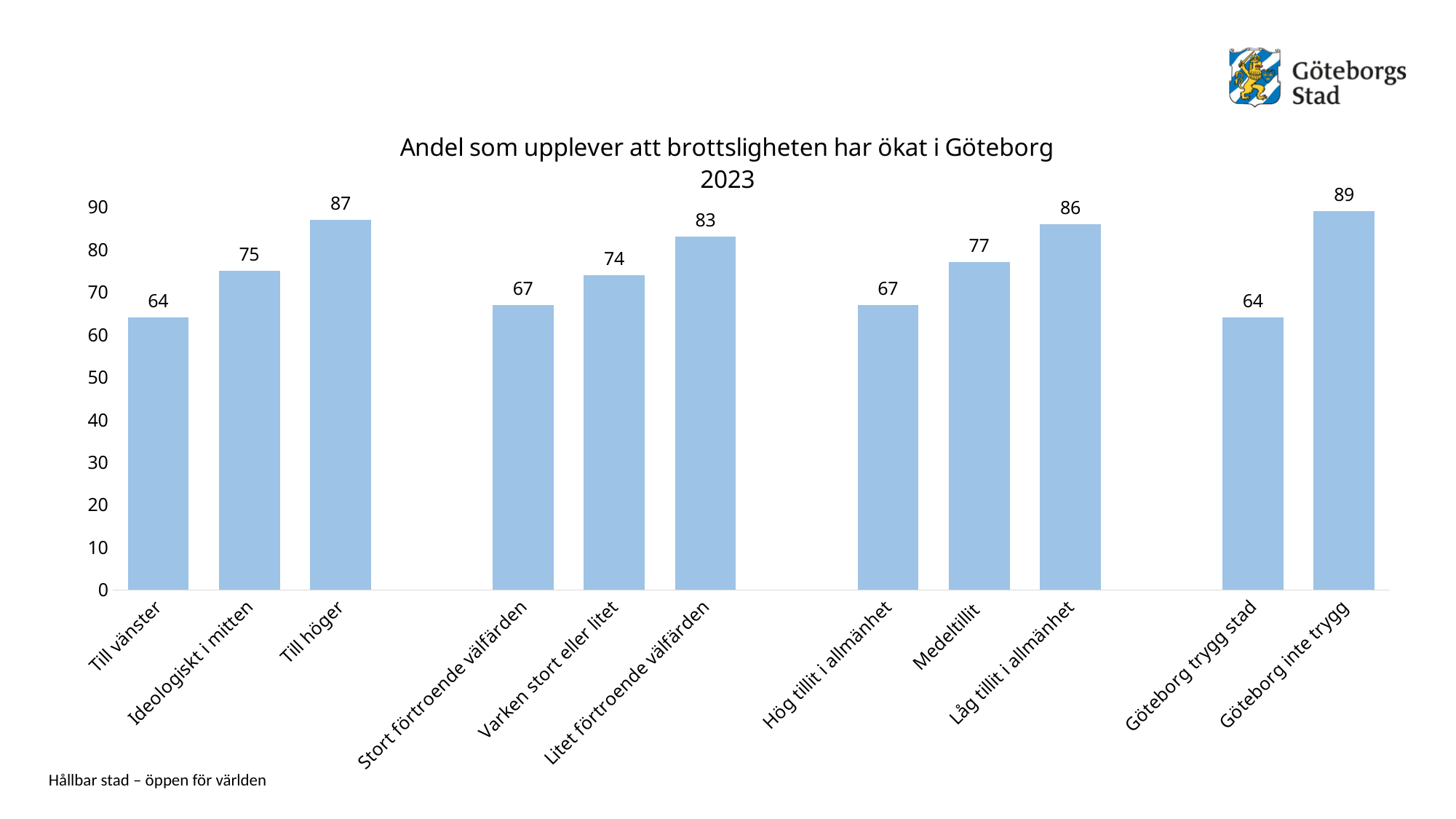
How many categories are shown in the chart? 12 Which category has the highest value? Göteborg inte trygg Is the value for Ideologiskt i mitten greater or less than 70? greater What is the difference between Göteborg inte trygg and Göteborg trygg stad? 25 Which is larger, the value for Låg tillit i allmänhet or the value for Hög tillit i allmänhet? Låg tillit i allmänhet What is the value for Medeltillit? 77 What is the difference between Till höger and Till vänster? 23 What is the title of the chart? Andel som upplever att brottsligheten har ökat i Göteborg 2023 What is the value for Litet förtroende välfärden? 83 Do the values rise or fall from Hög tillit i allmänhet to Låg tillit i allmänhet? Rise What is the value for Till höger? 87 What kind of chart is shown on the slide? Bar chart